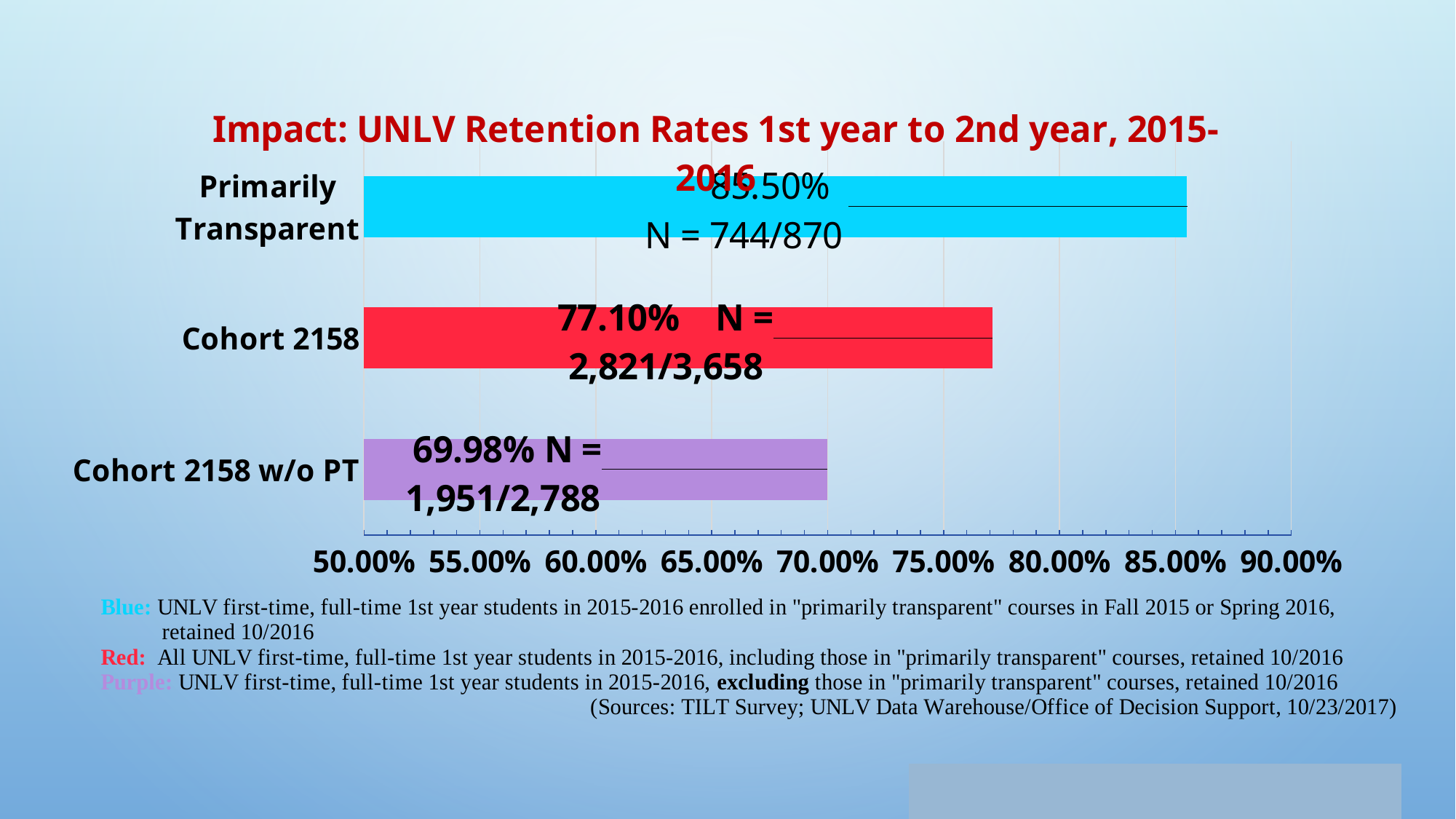
Which has a higher retention rate, Cohort 2158 or Cohort 2158 w/o PT? Cohort 2158 How many categories are shown in the chart? 3 Is the retention rate for Cohort 2158 w/o PT greater or less than 75.00%? less What N value is printed for Cohort 2158? 2,821/3,658 Which category has the highest retention rate? Primarily Transparent What is the retention rate shown for Cohort 2158 w/o PT? 69.98% Which category has the lowest retention rate? Cohort 2158 w/o PT What N value is printed for Cohort 2158 w/o PT? 1,951/2,788 What is the retention rate shown for the Primarily Transparent group? 85.50% What is the difference in retention rate between Cohort 2158 and Cohort 2158 w/o PT? 7.12% What type of chart is shown on the slide? bar chart What is the retention rate shown for Cohort 2158? 77.10%